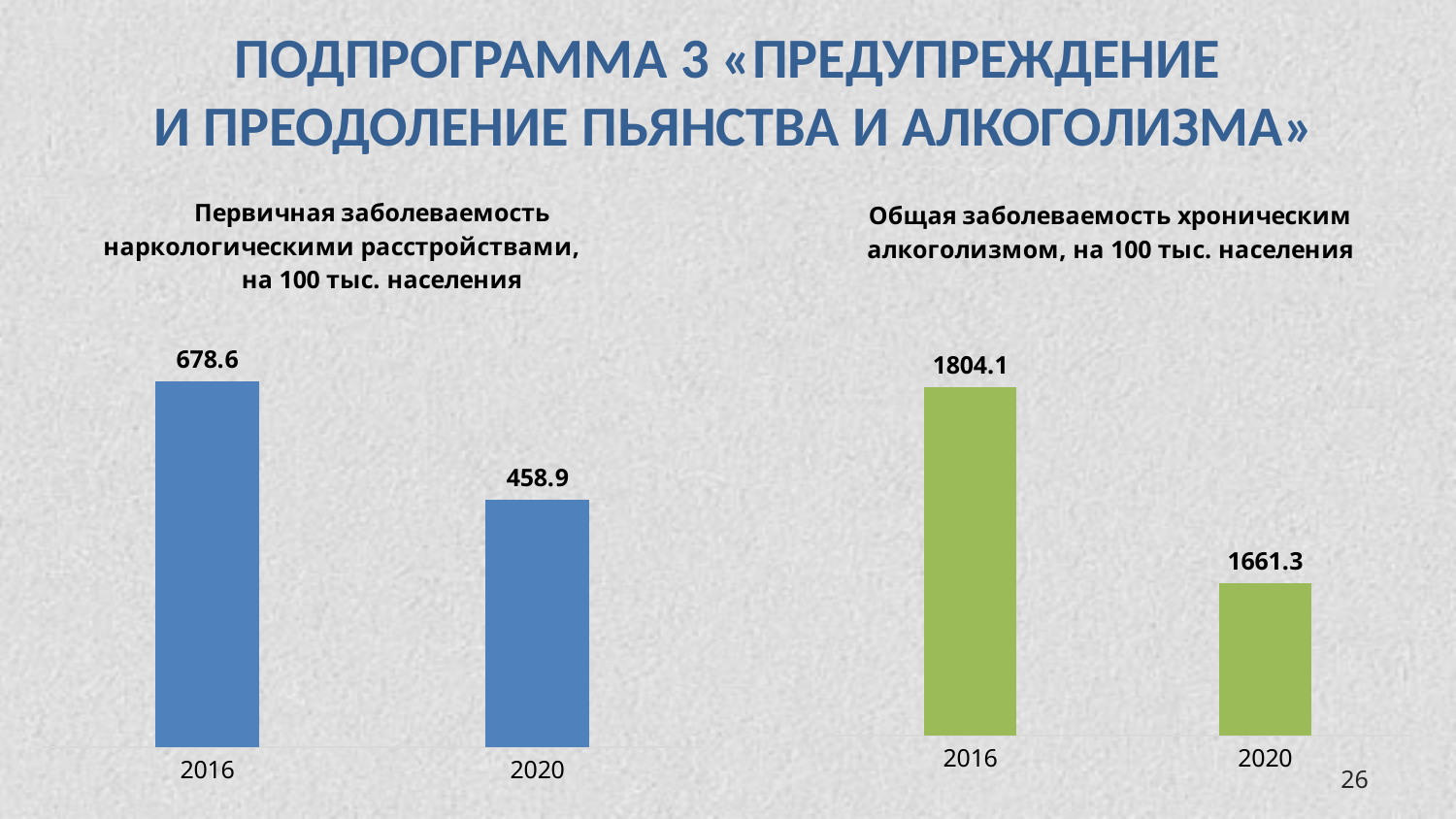
In the right chart, which year has the lower value? 2020 In the right chart, is the value for 2016 larger or smaller than the value for 2020? larger In the right chart, what is the difference between the 2016 and 2020 values? 142.8 In the left chart, what is the difference between the 2016 and 2020 values? 219.7 In the left chart (Первичная заболеваемость наркологическими расстройствами), what is the value for 2020? 458.9 In the left chart (Первичная заболеваемость наркологическими расстройствами), what is the value for 2016? 678.6 In the left chart, do the values rise or fall from 2016 to 2020? fall In the right chart (Общая заболеваемость хроническим алкоголизмом), what is the value for 2020? 1661.3 What type of chart is the right chart? bar chart In the left chart, which year has the higher value? 2016 How many categories (years) are shown in the left chart? 2 In the right chart (Общая заболеваемость хроническим алкоголизмом), what is the value for 2016? 1804.1